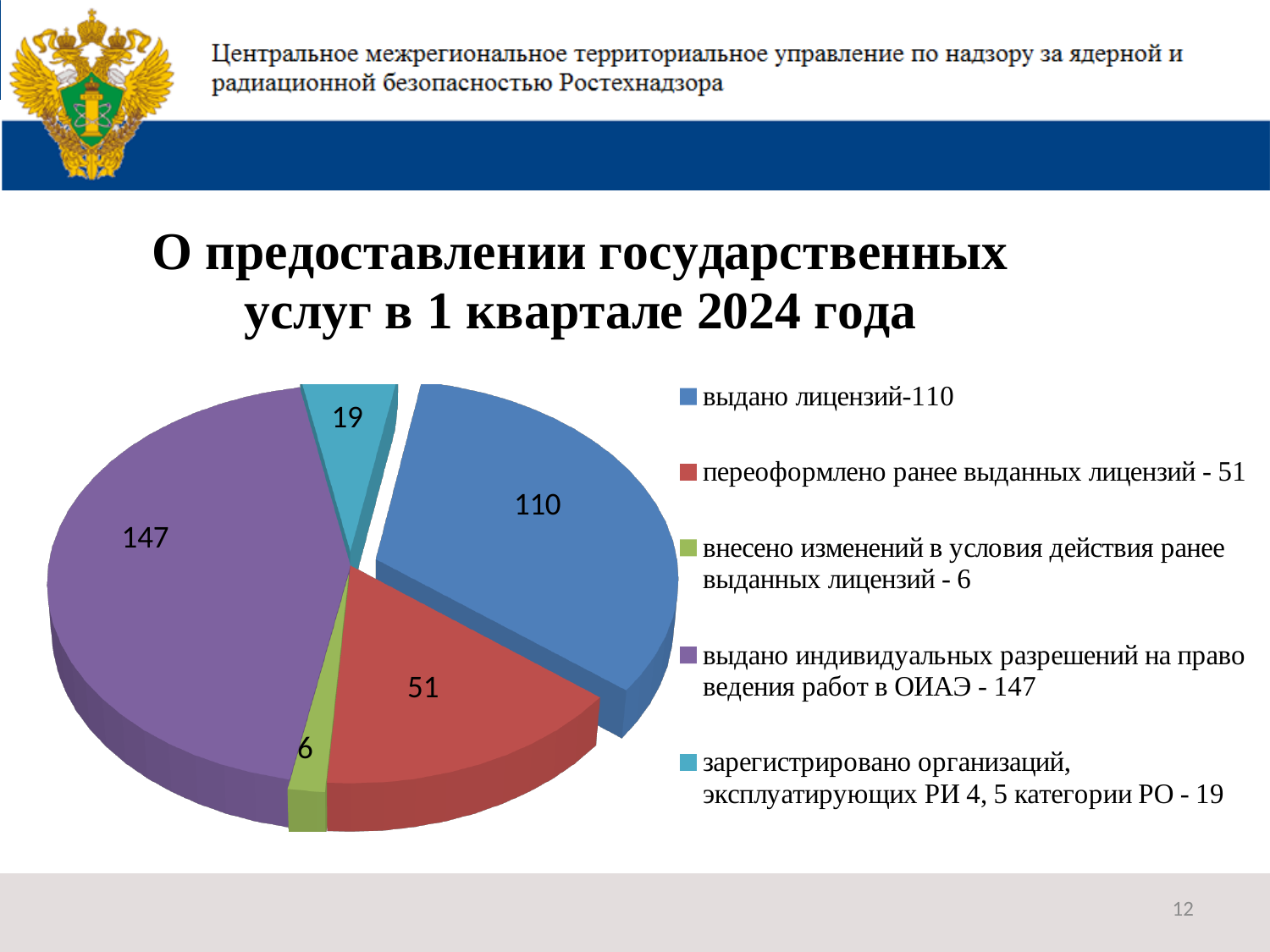
How many entries does the legend of the pie chart list? 5 What colour is the slice for 'выдано лицензий' in the pie chart? blue Which is larger: the value for 'переоформлено ранее выданных лицензий' or the value for 'зарегистрировано организаций, эксплуатирующих РИ 4, 5 категории РО'? переоформлено ранее выданных лицензий What is the value for 'зарегистрировано организаций, эксплуатирующих РИ 4, 5 категории РО'? 19 What is the difference between the value for 'выдано индивидуальных разрешений на право ведения работ в ОИАЭ' and the value for 'выдано лицензий'? 37 What is the value for 'переоформлено ранее выданных лицензий'? 51 How many slices does the pie chart have? 5 Which category has the smallest slice in the pie chart? внесено изменений в условия действия ранее выданных лицензий What is the total of all values shown in the pie chart? 333 What type of chart is shown on the slide? pie chart What is the value for 'выдано лицензий' in the pie chart? 110 Which category has the largest slice in the pie chart? выдано индивидуальных разрешений на право ведения работ в ОИАЭ